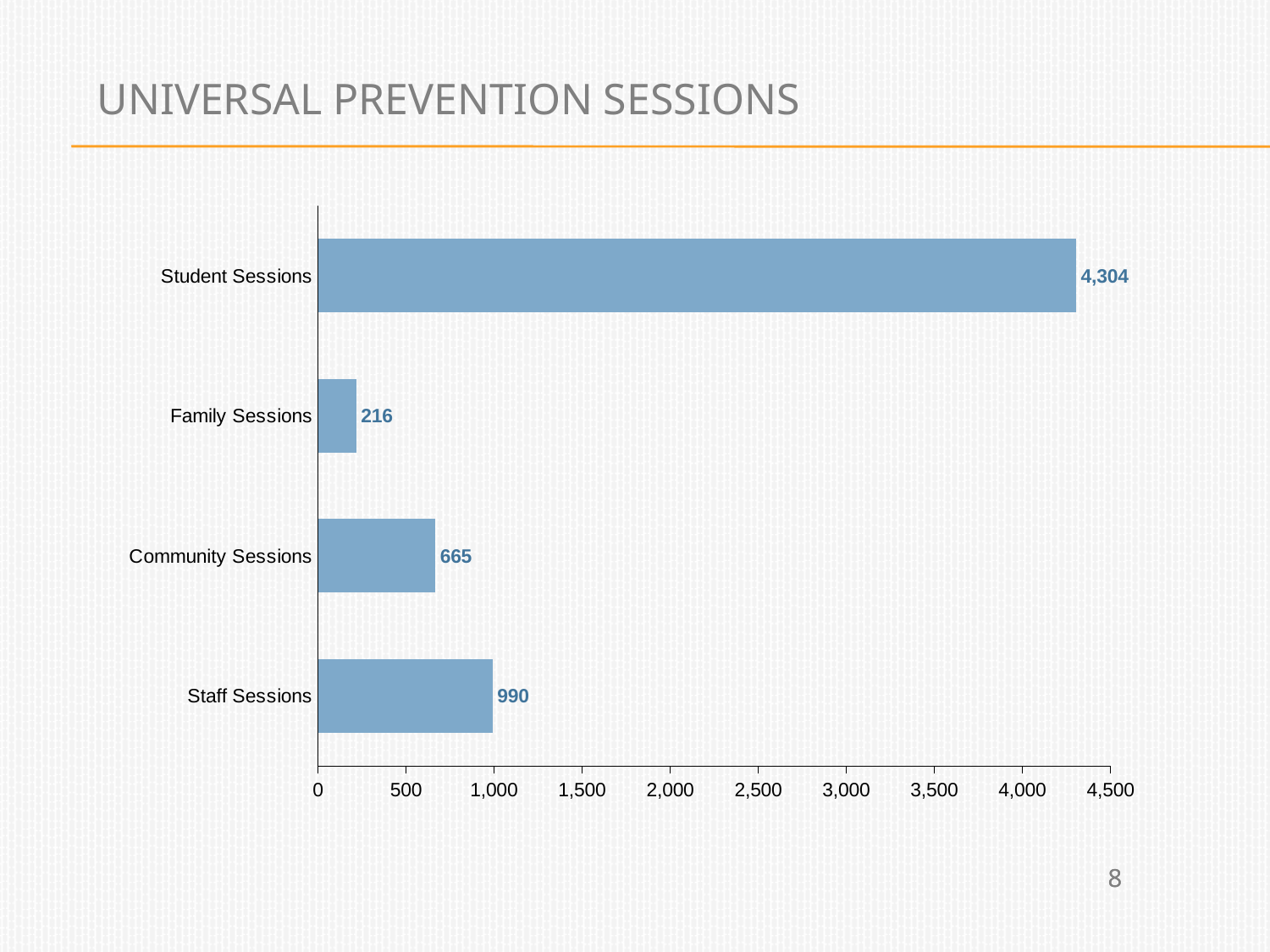
Which is larger, Community Sessions or Family Sessions? Community Sessions What is the value for Community Sessions? 665 How many categories are shown in the chart? 4 What is the value for Staff Sessions? 990 Which category has the lowest value? Family Sessions Which category has the highest value? Student Sessions What is the value for Family Sessions? 216 Is the value for Staff Sessions greater or less than 1,000? less What is the difference between Staff Sessions and Community Sessions? 325 What is the difference between Student Sessions and Staff Sessions? 3,314 What is the value for Student Sessions? 4,304 What kind of chart is shown on the slide? Bar chart